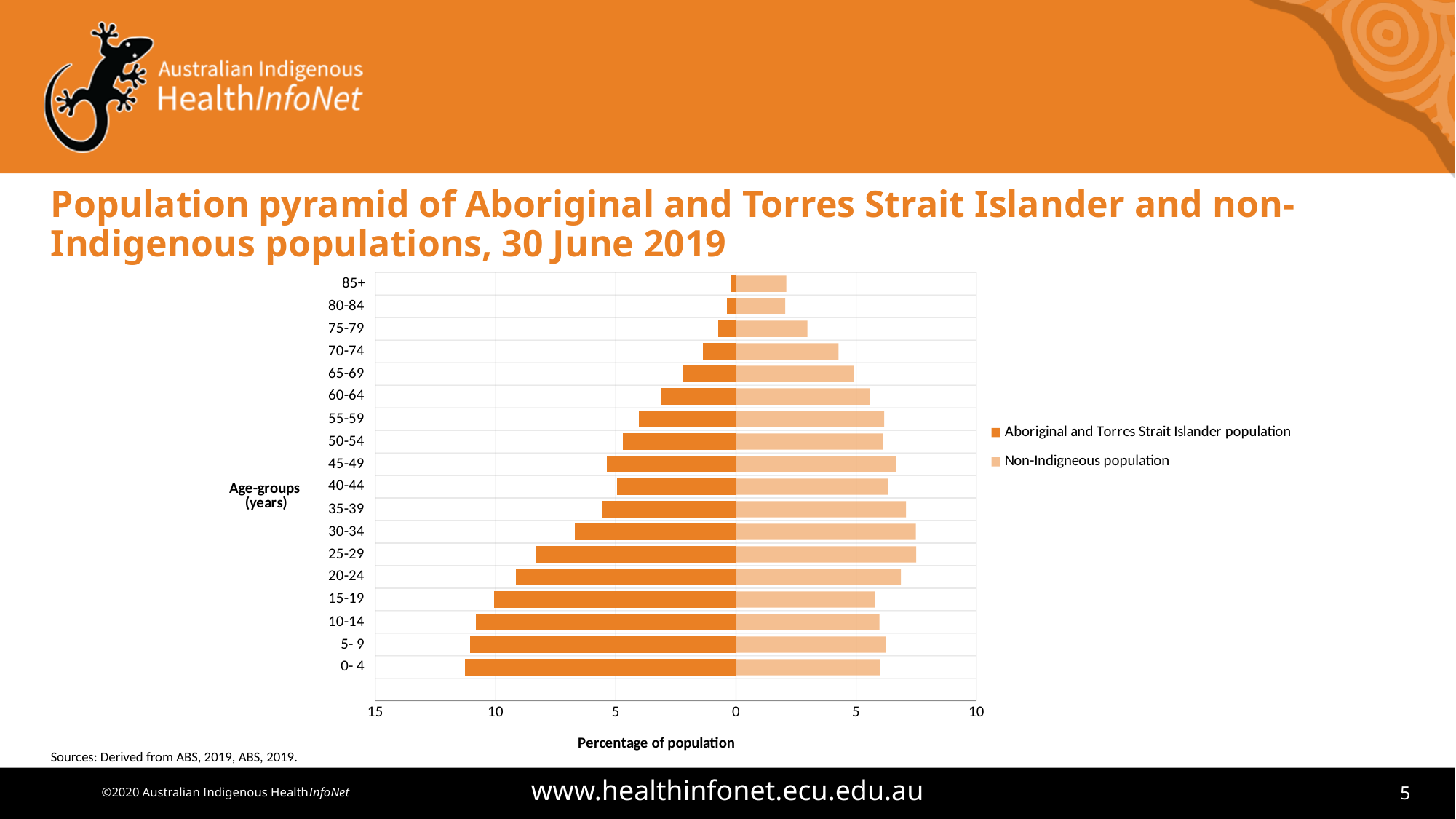
In the 85+ age group, which population has the larger value: Aboriginal and Torres Strait Islander or Non-Indigenous? Non-Indigenous population Is the value for the Non-Indigenous population in the 85+ age group greater or less than 5? less How many age groups are shown on the chart? 18 In the 0-4 age group, which population has the larger value: Aboriginal and Torres Strait Islander or Non-Indigenous? Aboriginal and Torres Strait Islander population Is the value for the Aboriginal and Torres Strait Islander population in the 0-4 age group greater or less than 10? greater How many series does the legend list? 2 What kind of chart is shown on the slide? bar chart Is the value for the Aboriginal and Torres Strait Islander population in the 65-69 age group greater or less than 5? less What is the title of the horizontal axis? Percentage of population Do the values for the Aboriginal and Torres Strait Islander population generally rise or fall as the age groups get older? fall